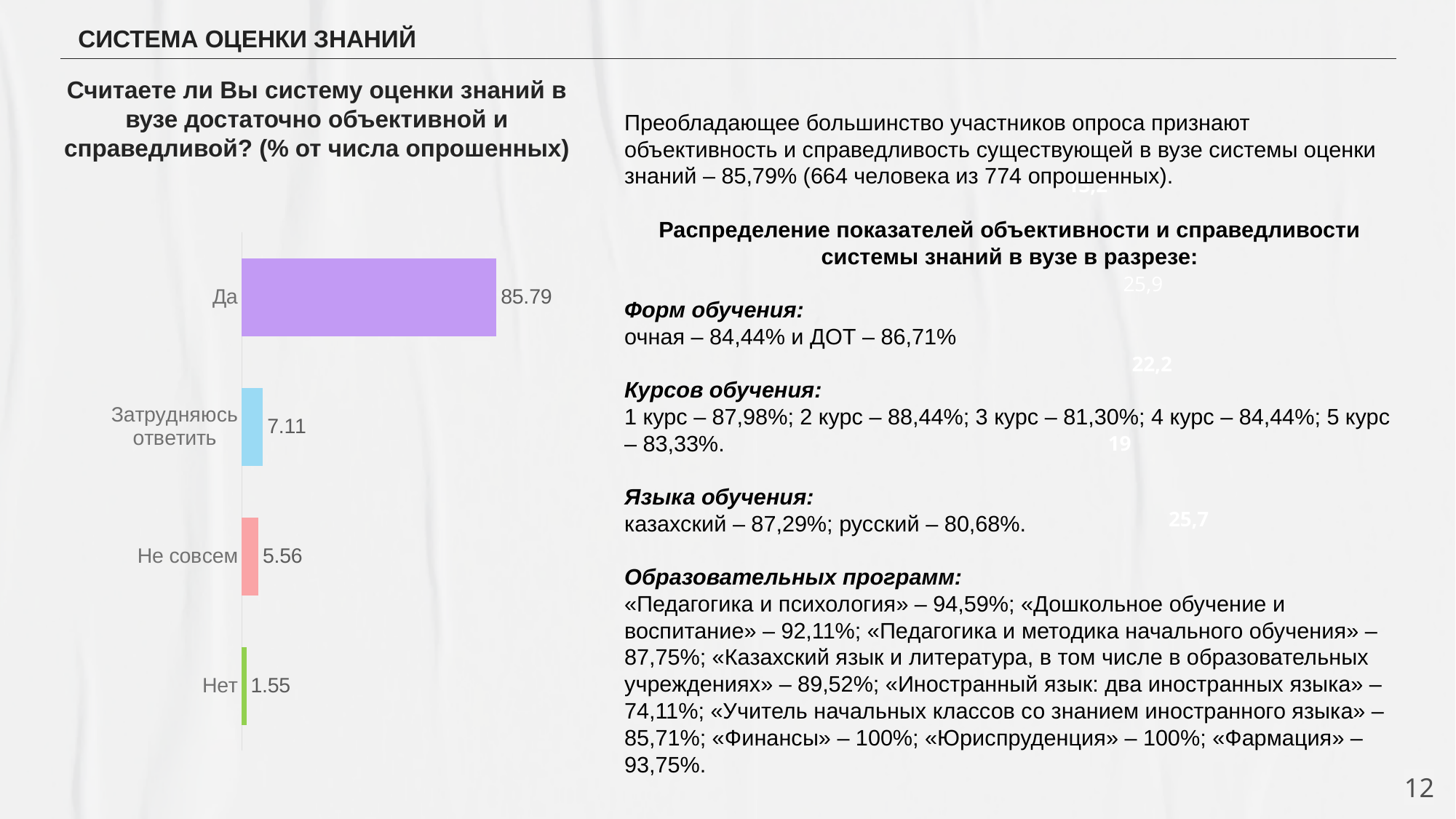
How many categories are shown in the chart? 4 Which category has the lowest value? Нет What kind of chart is shown on the slide? Bar chart Which is larger, the value for "Затрудняюсь ответить" or for "Не совсем"? Затрудняюсь ответить What is the difference between the values for "Не совсем" and "Нет"? 4.01 What is the difference between the values for "Да" and "Затрудняюсь ответить"? 78.68 What value is shown for "Нет"? 1.55 Which category has the highest value? Да What value is shown for "Затрудняюсь ответить"? 7.11 What value is shown for "Не совсем"? 5.56 What value is shown for the "Да" bar? 85.79 What colour is the bar for "Да"? Purple